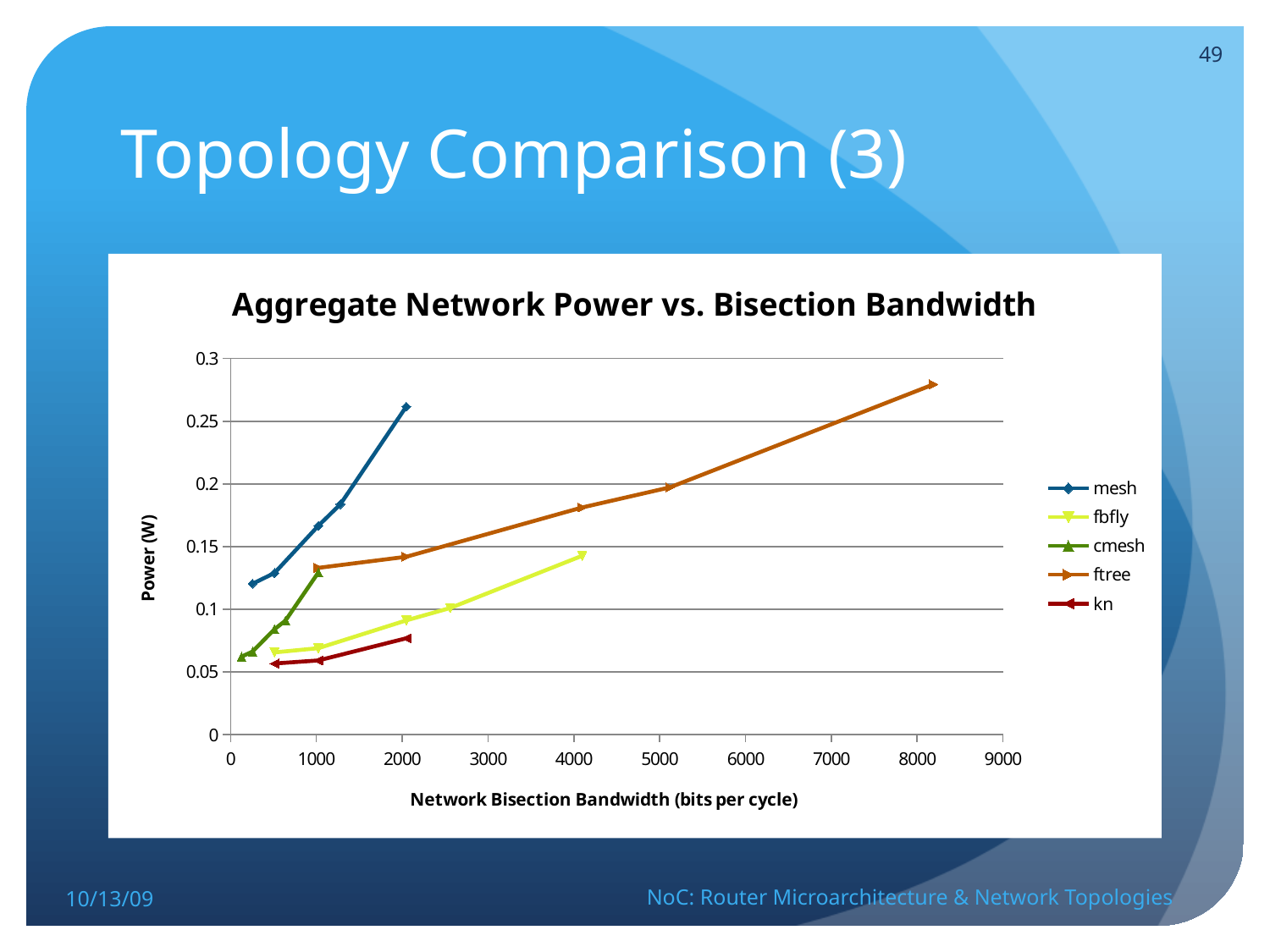
At a bisection bandwidth of about 2000, which series has the higher power: mesh or kn? mesh Does the power for the mesh series rise or fall as bisection bandwidth increases? rise Which series extends to the highest network bisection bandwidth? ftree Is the lowest power value of the kn series greater or less than 0.1? less Is the power of the mesh series at a bandwidth of 1000 greater or less than 0.15? greater How many data points does the kn series have? 3 How many series does the legend list? 5 What is the label of the vertical axis? Power (W) What kind of chart is shown on the slide? line chart Is the highest power value of the ftree series greater or less than 0.25? greater What is the title of the chart? Aggregate Network Power vs. Bisection Bandwidth Which series reaches the highest power value on the chart? ftree